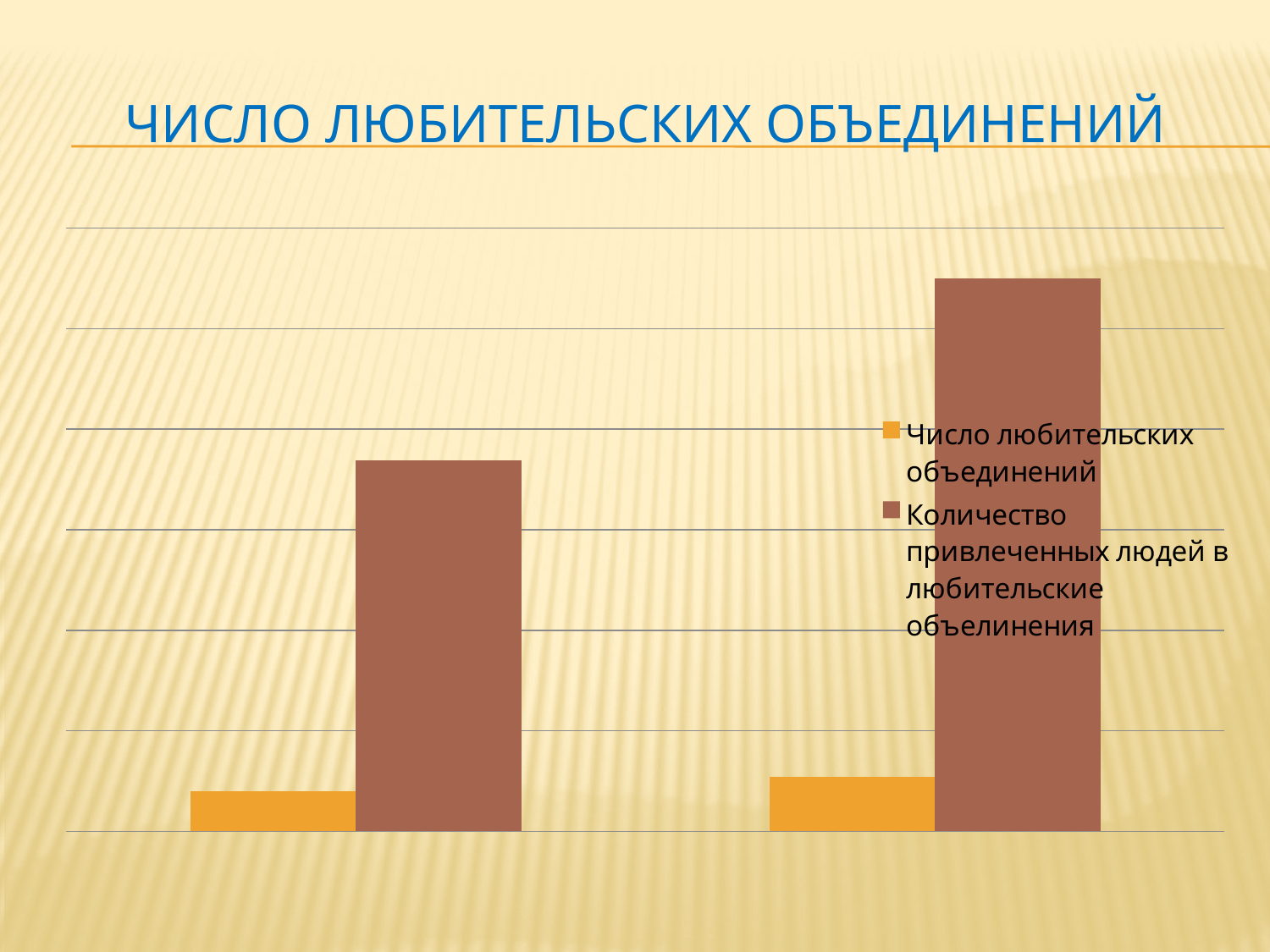
Which group of bars, left or right, has the shortest bar for Число любительских объединений? left Which series is shown in orange in the legend? Число любительских объединений What is the title of the chart slide? ЧИСЛО ЛЮБИТЕЛЬСКИХ ОБЪЕДИНЕНИЙ How many groups of bars are plotted in the chart? 2 Which group of bars, left or right, has the tallest bar for Количество привлеченных людей в любительские объединения? right In the left group of bars, which series has the taller bar: Число любительских объединений or Количество привлеченных людей в любительские объединения? Количество привлеченных людей в любительские объединения Do the bars for Количество привлеченных людей в любительские объединения rise or fall from the left group to the right group? rise What kind of chart is shown on the slide? bar chart In the right group of bars, which series has the taller bar: Число любительских объединений or Количество привлеченных людей в любительские объединения? Количество привлеченных людей в любительские объединения Is the bar for Количество привлеченных людей в любительские объединения in the right group taller or shorter than the same series' bar in the left group? taller How many series does the chart's legend list? 2